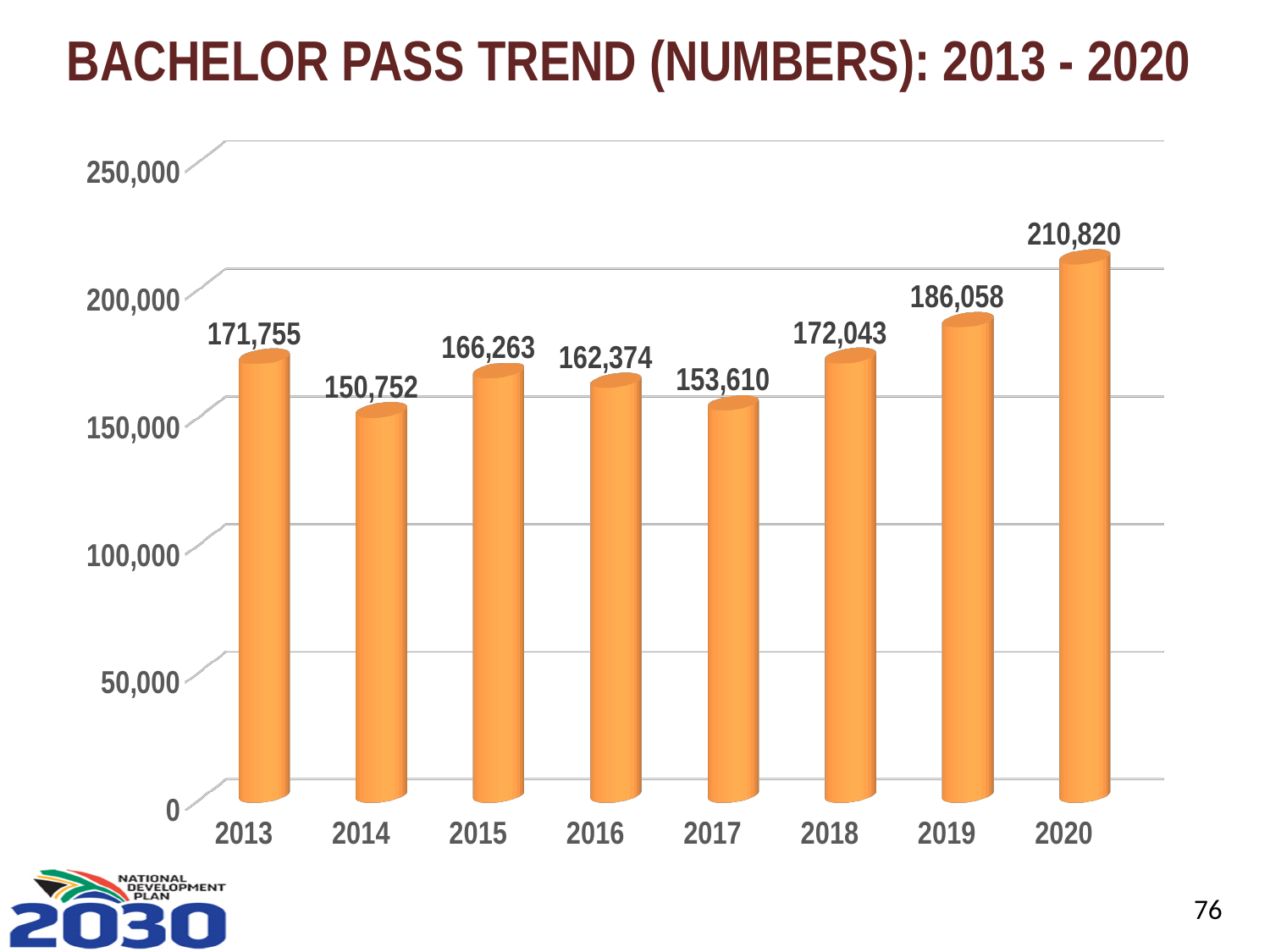
How many years are shown on the x axis? 8 What is the difference between the number of bachelor passes in 2013 and 2014? 21,003 Is the value for 2018 greater or less than 150,000? greater Which year had more bachelor passes, 2015 or 2016? 2015 What is the number of bachelor passes in 2013? 171,755 Which year has the lowest number of bachelor passes? 2014 What is the title of the chart? BACHELOR PASS TREND (NUMBERS): 2013 - 2020 What is the number of bachelor passes in 2017? 153,610 What kind of chart is shown on the slide? Bar chart What is the number of bachelor passes in 2019? 186,058 What is the difference between the number of bachelor passes in 2020 and 2019? 24,762 Which year has the highest number of bachelor passes? 2020